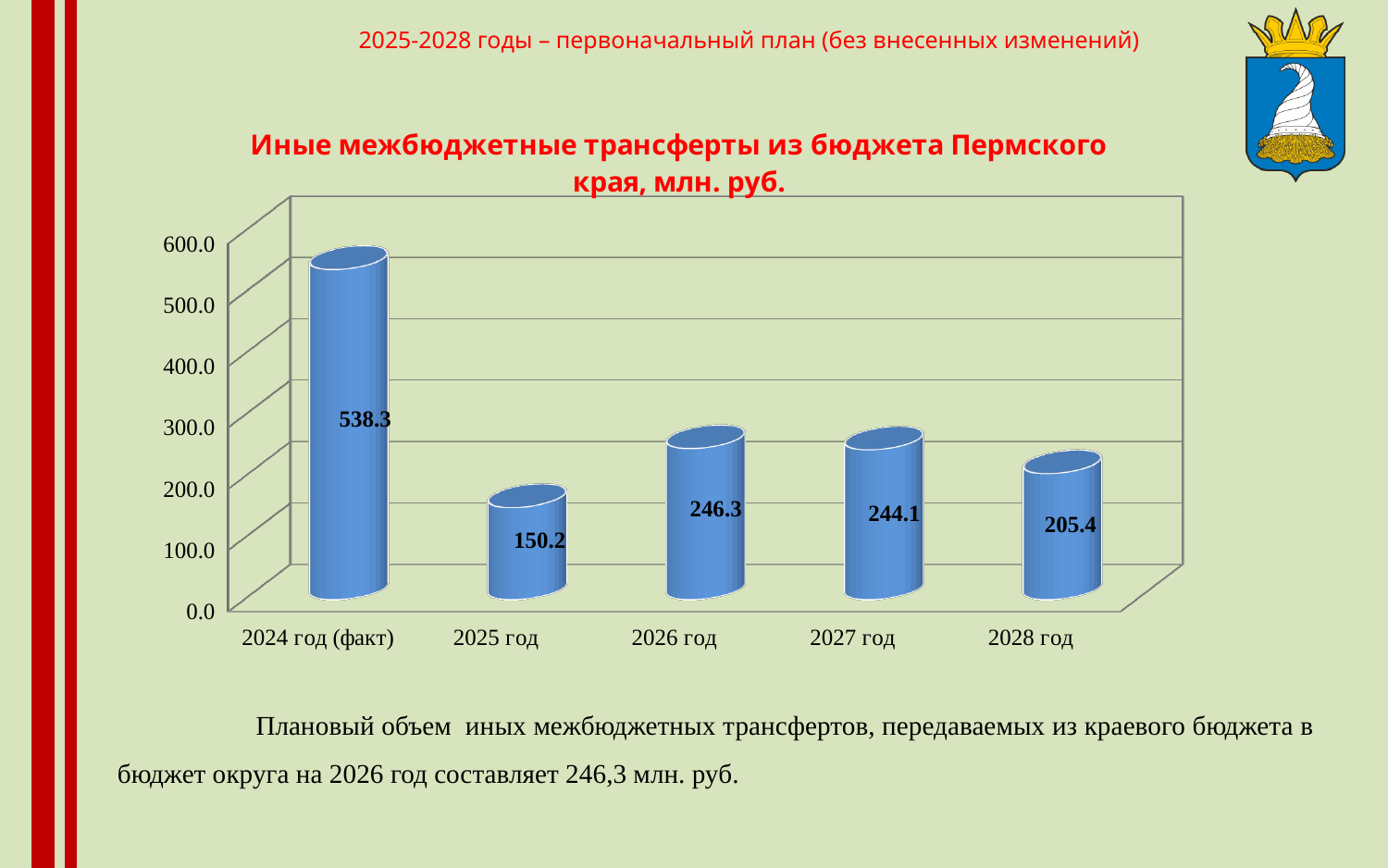
Which year has the highest value? 2024 год (факт) Is the value for 2027 год greater or less than 200.0? greater What kind of chart is shown on the slide? bar chart Which is larger, the value for 2026 год or the value for 2028 год? 2026 год How many categories are shown on the x axis? 5 Which year has the lowest value? 2025 год What is the value for 2024 год (факт)? 538.3 What is the difference between the values for 2024 год (факт) and 2025 год? 388.1 What is the value for 2028 год? 205.4 What is the title of the chart? Иные межбюджетные трансферты из бюджета Пермского края, млн. руб. What is the difference between the values for 2026 год and 2028 год? 40.9 What is the value for 2025 год? 150.2